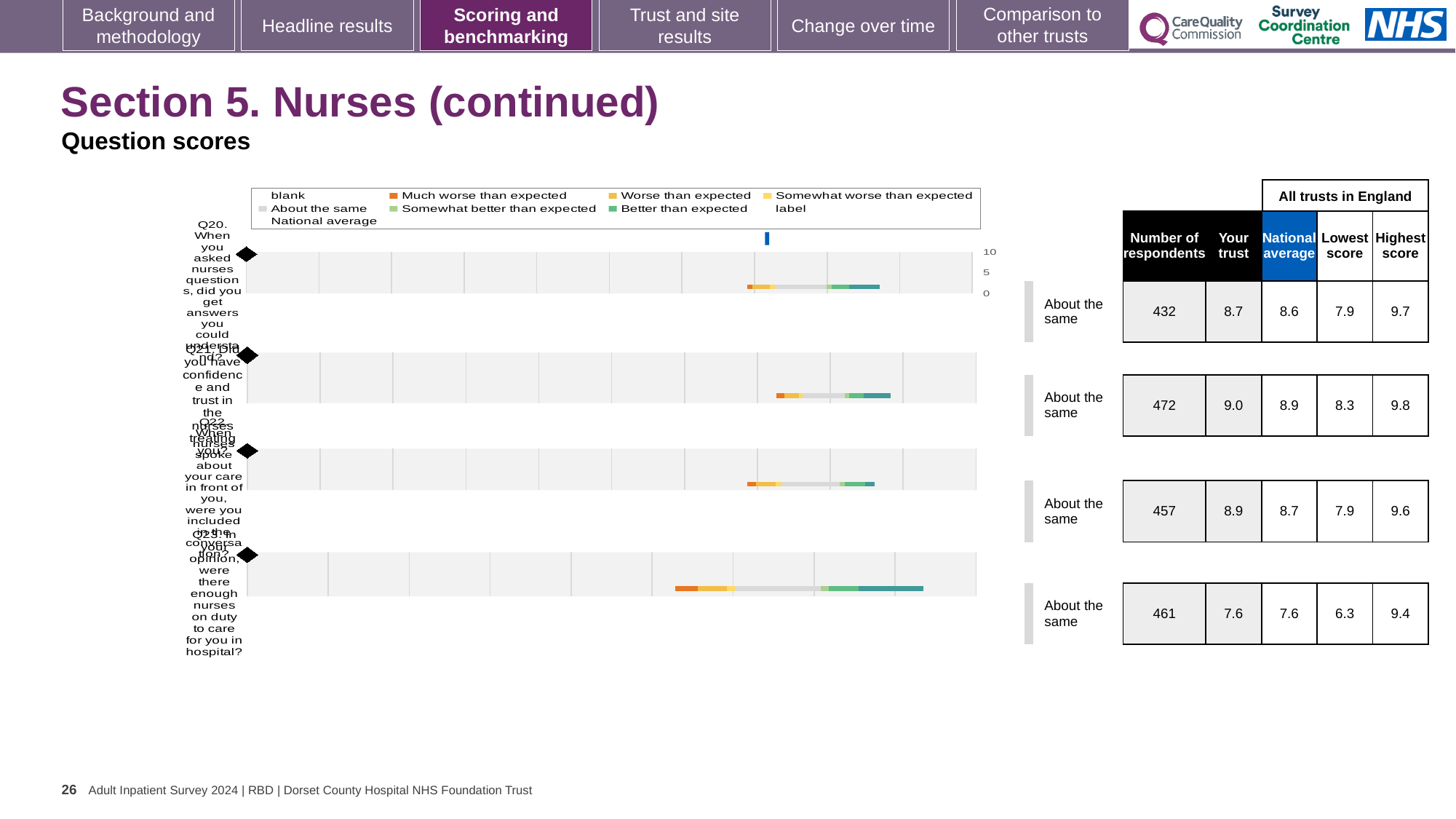
What benchmark category is shown next to the chart for Q23? About the same Which question has the lowest 'Your trust' score in the table beside the chart? Q23 For Q20, what is the difference between the 'Your trust' score and the national average in the table beside the chart? 0.1 How many questions (bars) are plotted in the chart? 4 In the table beside the chart, what is the 'Your trust' score for Q21 (confidence and trust in the nurses)? 9.0 In the table beside the chart, what is the highest score among all trusts in England for Q21? 9.8 In the table beside the chart, what is the national average for Q23 (enough nurses on duty)? 7.6 Which question has the highest 'Your trust' score in the table beside the chart? Q21 In the table beside the chart, how many respondents are listed for Q20? 432 What kind of chart is shown on the slide? bar chart For Q22, which is larger in the table beside the chart: the 'Your trust' score or the national average? Your trust In the table beside the chart, what is the lowest score among all trusts in England for Q22? 7.9